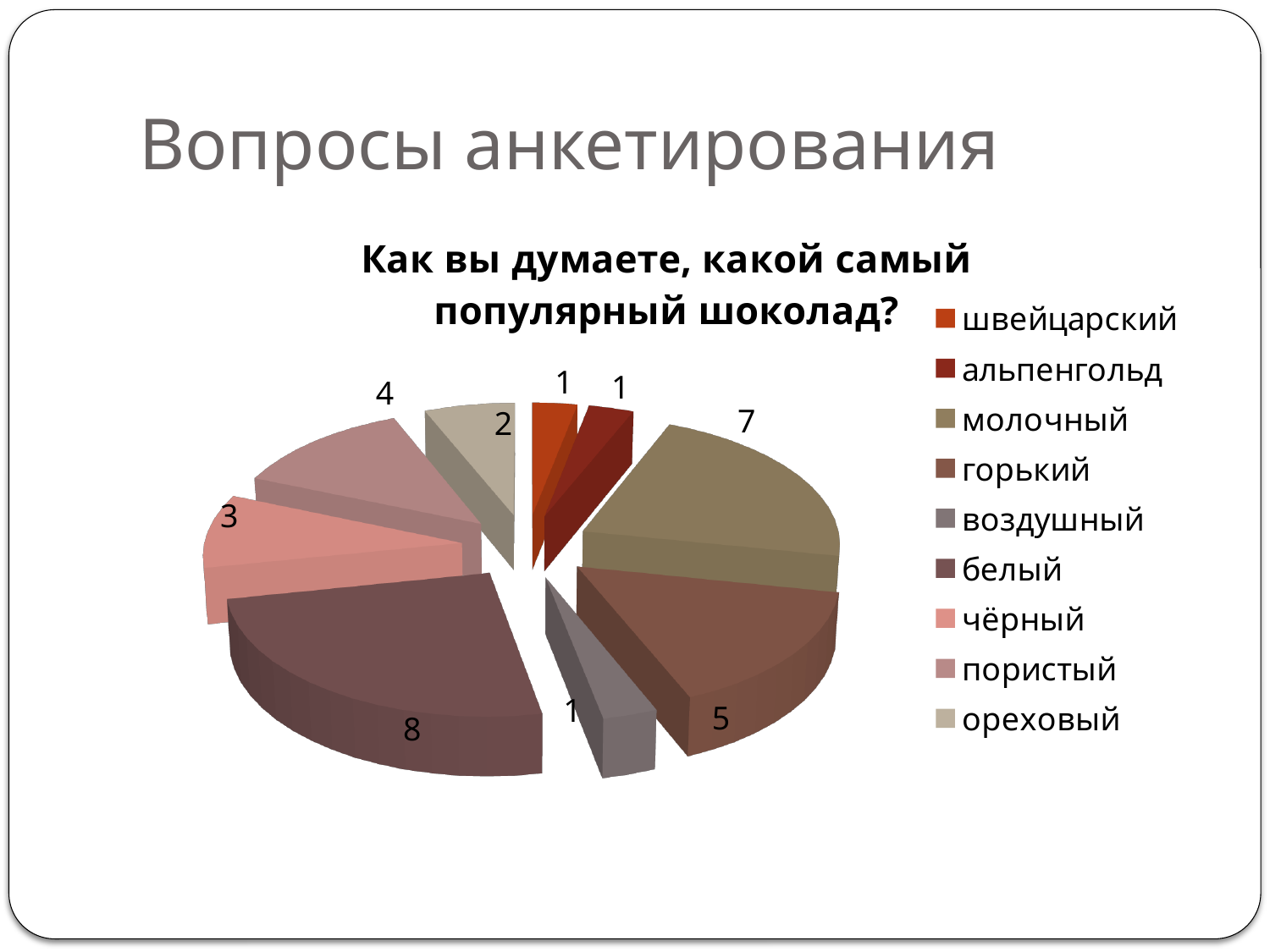
What is the value for молочный? 7 Which category has the largest slice? белый How many categories does the pie chart have? 9 Which is larger, the value for молочный or the value for горький? молочный What share of the pie does белый represent? 25% What is the value for горький? 5 What is the difference between the values for белый and чёрный? 5 What is the total of all the values in the pie chart? 32 What is the value for белый? 8 What kind of chart is shown on the slide? pie chart What is the title of the chart? Как вы думаете, какой самый популярный шоколад? What is the value for пористый? 4